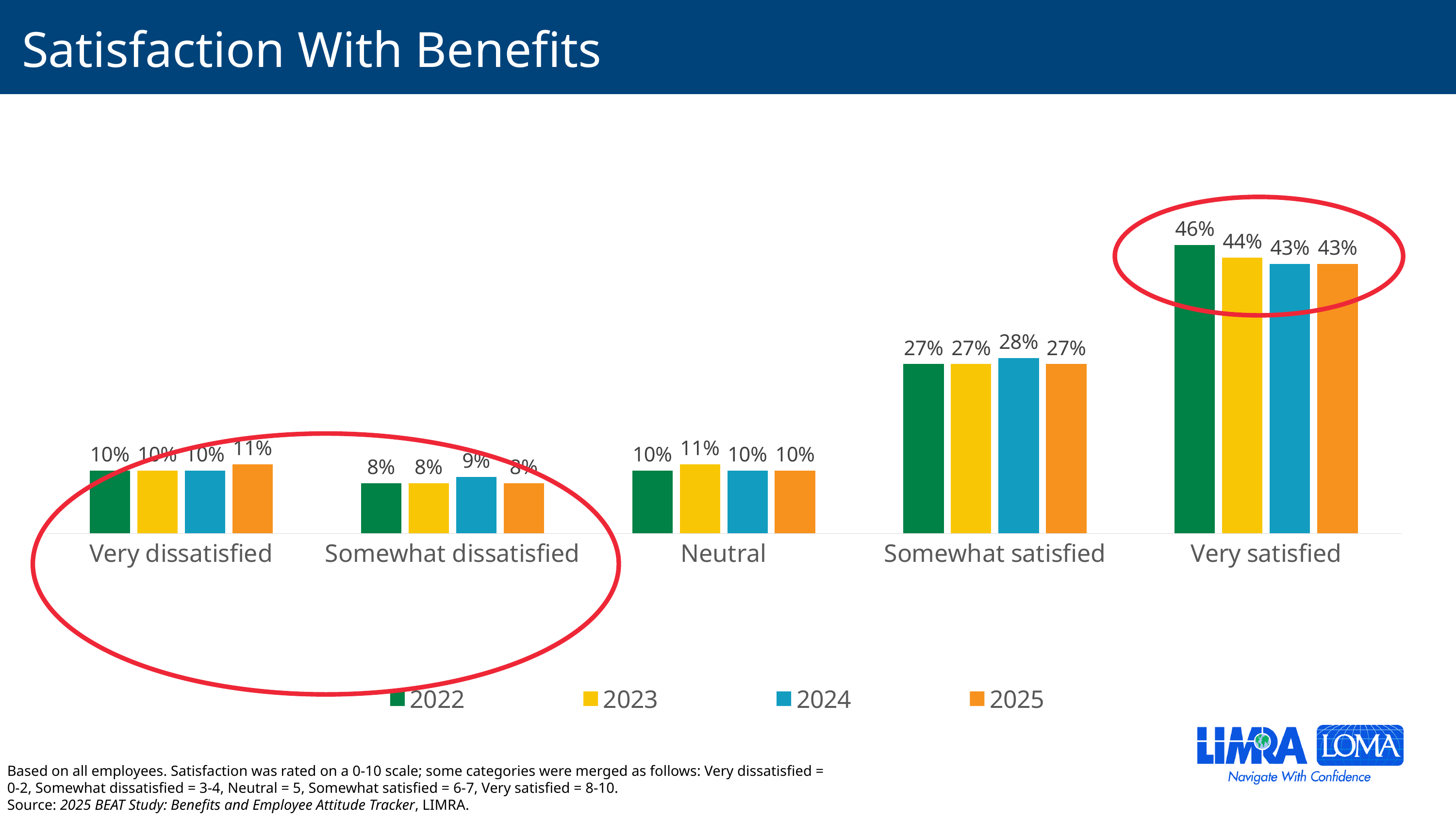
What is the value for Neutral in 2023? 11% What is the value for Somewhat satisfied in 2024? 28% Which is larger: the 2022 value for Very satisfied or the 2022 value for Somewhat satisfied? Very satisfied What is the difference between the 2022 and 2025 values for Very satisfied? 3% How many categories are shown on the x axis? 5 What is the value for Very satisfied in 2022? 46% Did the value for Very satisfied rise or fall from 2022 to 2025? Fall Which category has the lowest value in 2022? Somewhat dissatisfied How many series does the legend list? 4 What is the value for Somewhat dissatisfied in 2025? 8% Which category has the highest value in 2025? Very satisfied What kind of chart is shown on the slide? Bar chart